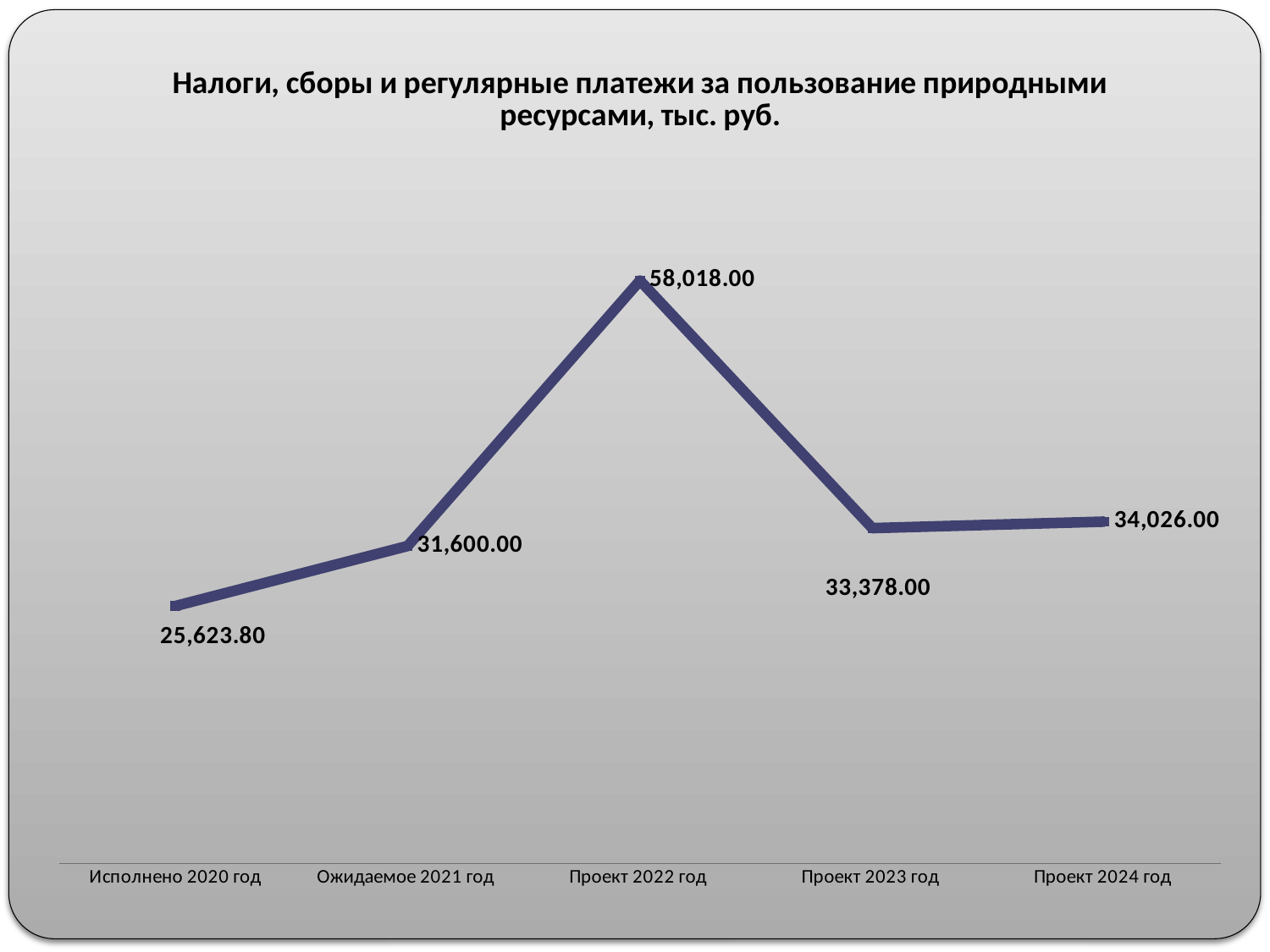
Which category has the highest value? Проект 2022 год How many data points are plotted on the chart? 5 Which is larger, the value for Ожидаемое 2021 год or the value for Проект 2023 год? Проект 2023 год What is the value for Исполнено 2020 год? 25,623.80 Which category has the lowest value? Исполнено 2020 год What is the value for Проект 2024 год? 34,026.00 What is the difference between the values for Проект 2024 год and Проект 2023 год? 648.00 What unit is stated in the chart title? тыс. руб. Does the value rise or fall from Проект 2022 год to Проект 2023 год? Fall What is the difference between the values for Проект 2022 год and Ожидаемое 2021 год? 26,418.00 What kind of chart is shown on the slide? Line chart What is the value for Проект 2022 год? 58,018.00